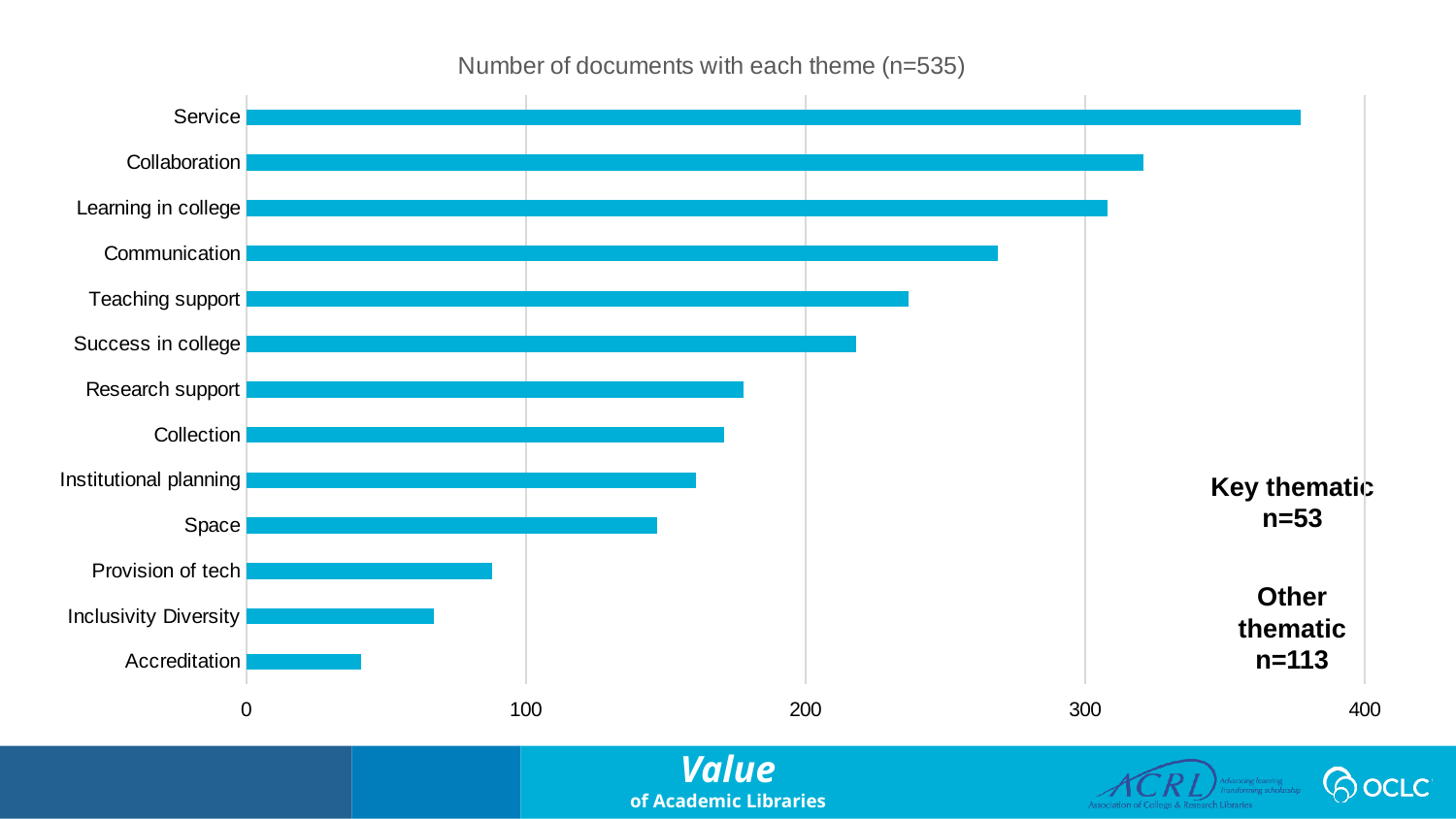
How many themes (categories) are plotted in the chart? 13 Is the value for Service greater or less than 300? greater Which theme has the highest number of documents? Service Which has more documents, Collaboration or Communication? Collaboration What kind of chart is shown on the slide? bar chart Is the value for Accreditation greater or less than 100? less Is the value for Communication greater or less than 300? less Which theme has the lowest number of documents? Accreditation What is the title of the chart? Number of documents with each theme (n=535) Which has fewer documents, Provision of tech or Inclusivity Diversity? Inclusivity Diversity